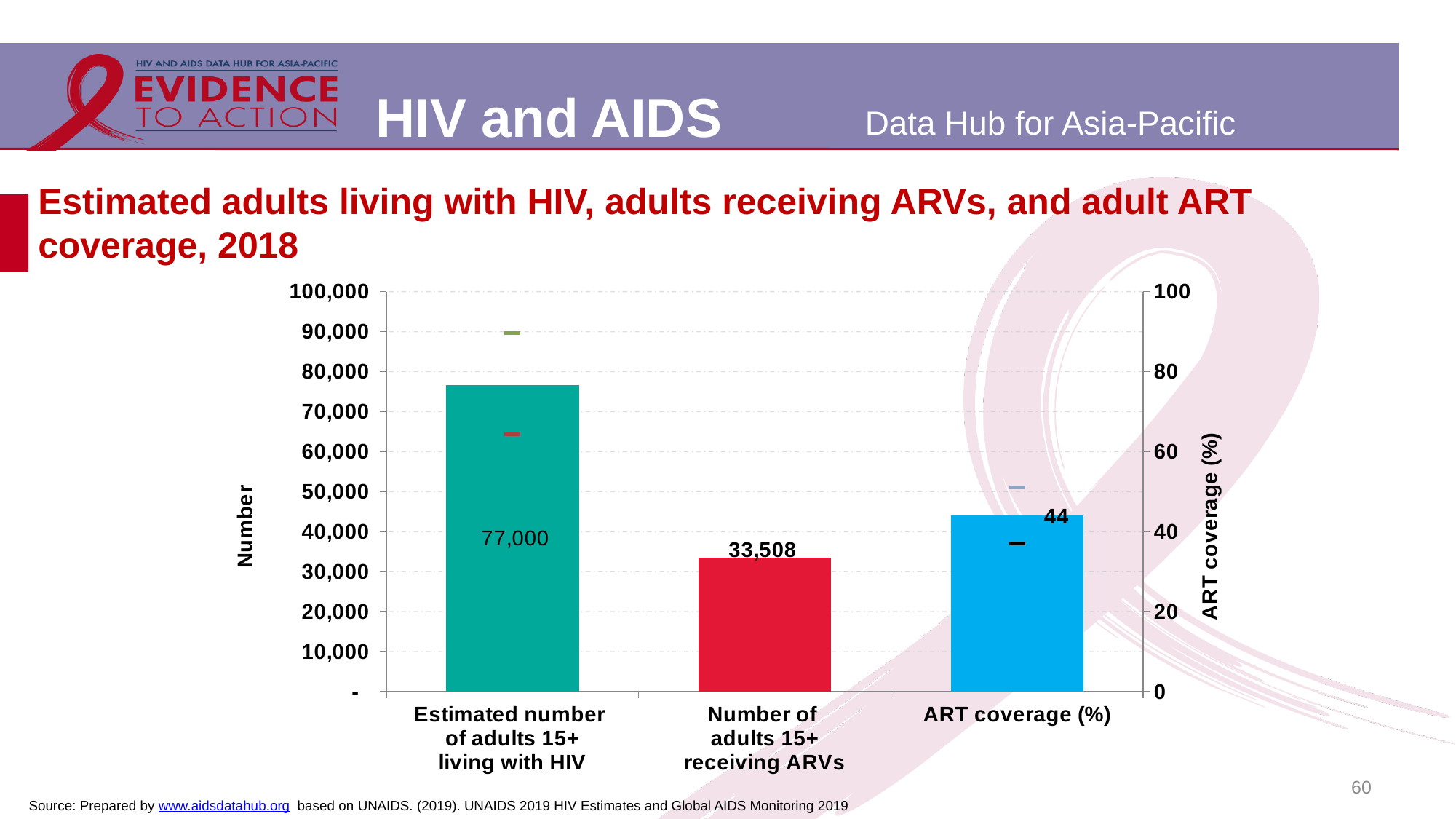
What is the difference between the estimated number of adults 15+ living with HIV and the number of adults 15+ receiving ARVs? 43,492 What is the estimated number of adults 15+ living with HIV shown on the chart? 77,000 Is the ART coverage (%) value greater or less than 40 on the right-hand axis? greater What is the label of the right-hand vertical axis of the chart? ART coverage (%) How many categories are shown on the x axis of the chart? 3 Which is larger: the estimated number of adults 15+ living with HIV or the number of adults 15+ receiving ARVs? Estimated number of adults 15+ living with HIV Is the value for the number of adults 15+ receiving ARVs greater or less than 40,000? less What is the ART coverage (%) value shown on the chart? 44 What kind of chart is shown on the slide? Bar chart Which category has the tallest bar on the chart? Estimated number of adults 15+ living with HIV What is the label of the left-hand vertical axis of the chart? Number What is the number of adults 15+ receiving ARVs shown on the chart? 33,508